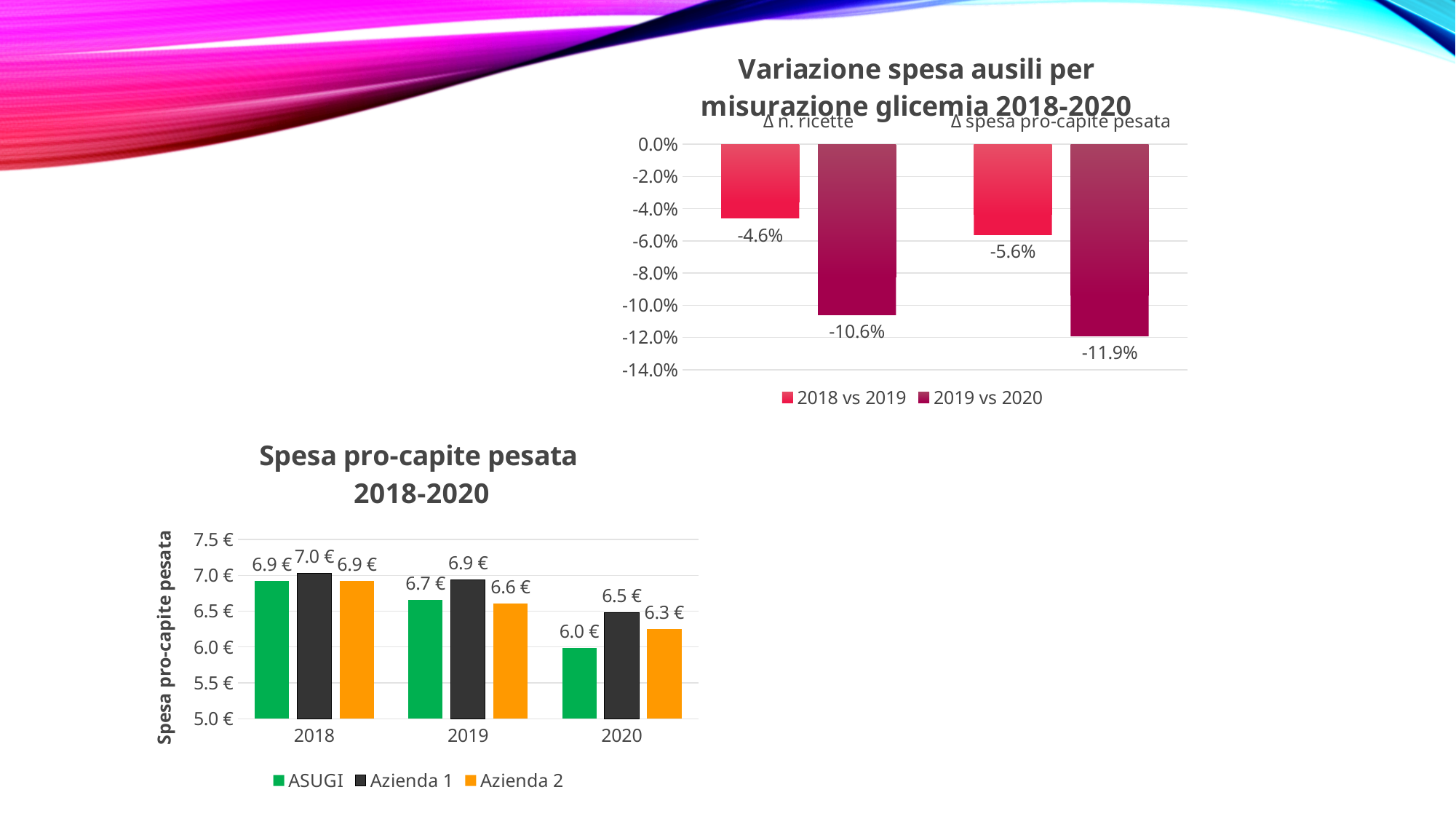
In the chart 'Spesa pro-capite pesata 2018-2020', what is the value for ASUGI in 2020? 6.0 € In the chart 'Spesa pro-capite pesata 2018-2020', how many years are shown on the x axis? 3 In the chart 'Spesa pro-capite pesata 2018-2020', what is the value for Azienda 1 in 2018? 7.0 € In the chart 'Spesa pro-capite pesata 2018-2020', which series has the highest value in 2020? Azienda 1 In the chart 'Variazione spesa ausili per misurazione glicemia 2018-2020', what is the value for 'Δ n. ricette' in the '2018 vs 2019' series? -4.6% In the chart 'Variazione spesa ausili per misurazione glicemia 2018-2020', what is the difference between the '2019 vs 2020' and '2018 vs 2019' values for 'Δ n. ricette'? 6.0 percentage points In the chart 'Variazione spesa ausili per misurazione glicemia 2018-2020', what is the value for 'Δ spesa pro-capite pesata' in the '2019 vs 2020' series? -11.9% In the chart 'Variazione spesa ausili per misurazione glicemia 2018-2020', which category has the lowest value in the '2019 vs 2020' series? Δ spesa pro-capite pesata What kind of chart is 'Spesa pro-capite pesata 2018-2020'? Bar chart In the chart 'Variazione spesa ausili per misurazione glicemia 2018-2020', how many series does the legend list? 2 In the chart 'Spesa pro-capite pesata 2018-2020', do the ASUGI values rise or fall from 2018 to 2020? Fall In the chart 'Spesa pro-capite pesata 2018-2020', is the value for Azienda 2 in 2020 larger or smaller than the value for ASUGI in 2020? Larger